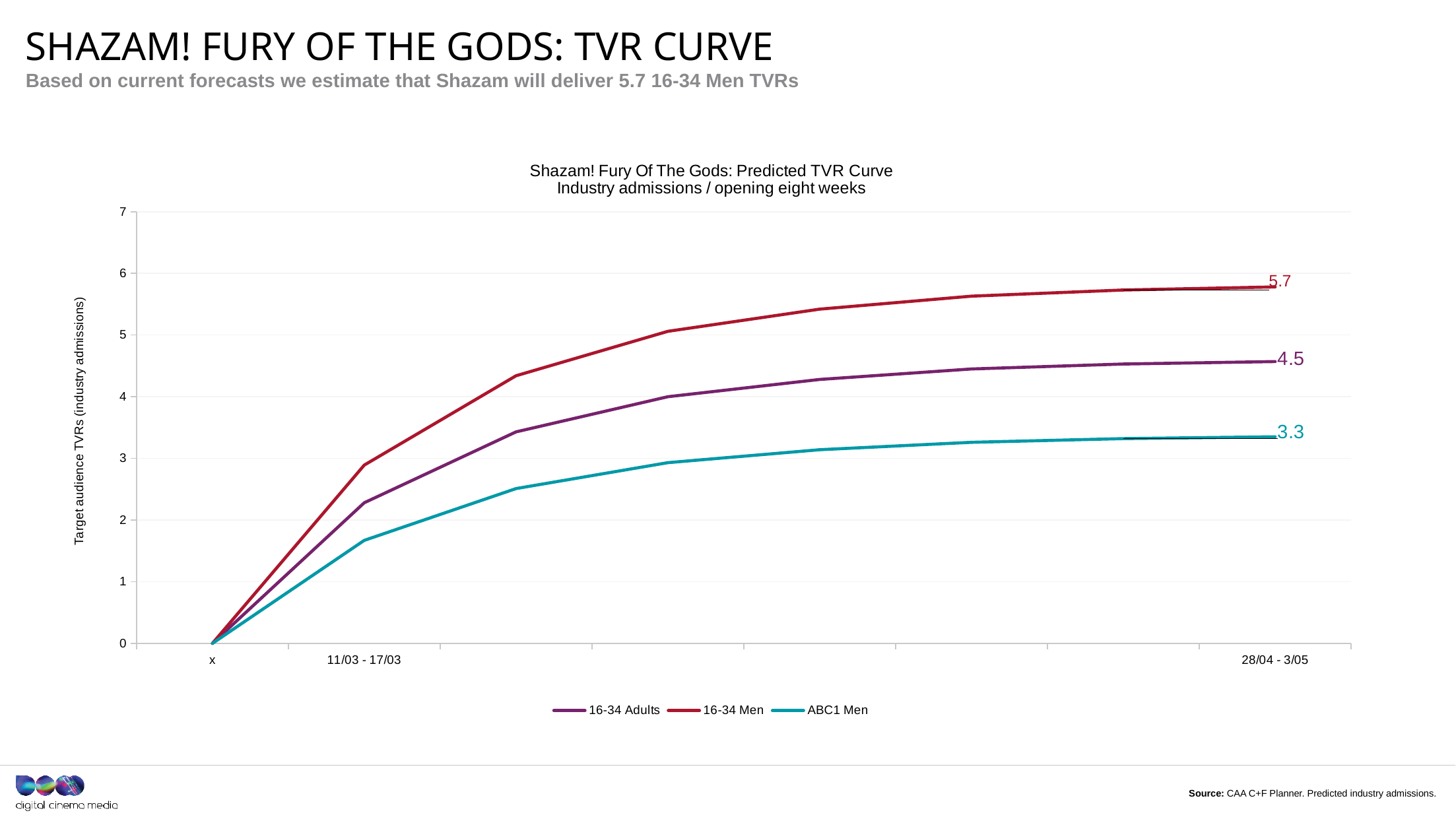
What is the final value of the 16-34 Adults line at 28/04 - 3/05? 4.5 What is the difference between the final values of 16-34 Men and 16-34 Adults? 1.2 What is the final value of the 16-34 Men line at 28/04 - 3/05? 5.7 How many series does the legend list? 3 What type of chart is shown on the slide? line chart Which series reaches the highest value at the end of the curve? 16-34 Men Is the value for 16-34 Adults at 11/03 - 17/03 greater or less than 3? less What is the title of the chart? Shazam! Fury Of The Gods: Predicted TVR Curve Industry admissions / opening eight weeks What is the final value of the ABC1 Men line at 28/04 - 3/05? 3.3 Which series reaches the lowest value at the end of the curve? ABC1 Men Do the values of the 16-34 Men line rise or fall along the x axis? rise What is the difference between the final values of 16-34 Men and ABC1 Men? 2.4